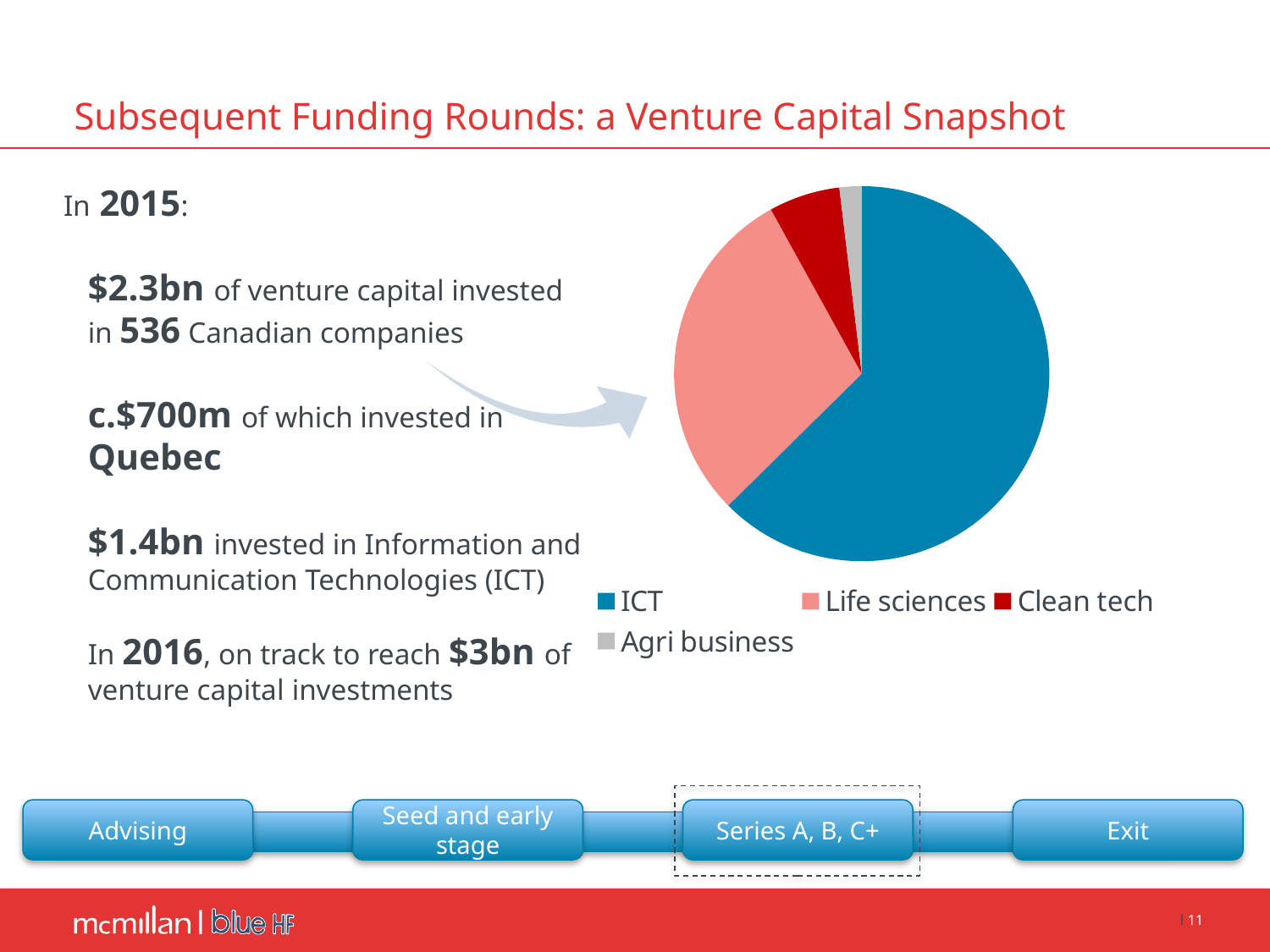
Which slice is larger in the pie chart, Clean tech or Agri business? Clean tech Which category has the smallest slice of the pie chart? Agri business Which category is the second-largest slice of the pie chart? Life sciences What kind of chart is shown on the slide? Pie chart Which slice is larger in the pie chart, ICT or Life sciences? ICT Which category in the pie chart legend is shown in grey? Agri business Which slice is larger in the pie chart, Life sciences or Clean tech? Life sciences How many slices does the pie chart have? 4 How many entries does the legend of the pie chart list? 4 Which category has the largest slice of the pie chart? ICT What colour is the Life sciences slice in the pie chart? Light red (pink)